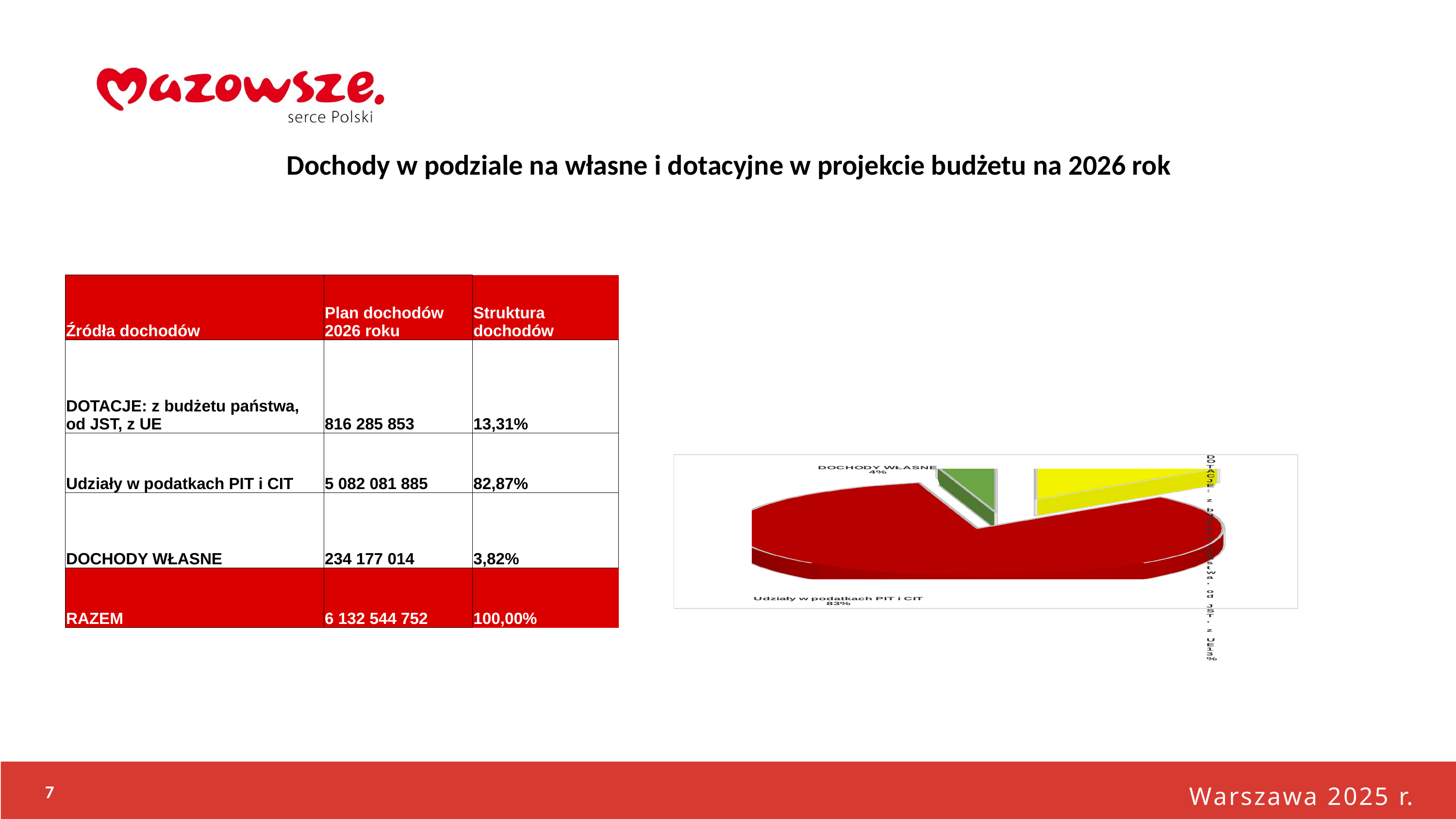
What share of the pie does "DOCHODY WŁASNE" have? 4% What share of the pie does "DOTACJE: z budżetu państwa, od JST, z UE" have? 13% What colour is the slice for Udziały w podatkach PIT i CIT in the pie chart? red How many slices does the pie chart have? 3 What colour is the slice for DOCHODY WŁASNE in the pie chart? green What is the difference in percentage points between the share for Udziały w podatkach PIT i CIT and the share for DOTACJE in the pie chart? 70 Which slice of the pie chart is the smallest? DOCHODY WŁASNE Which slice of the pie chart is the largest? Udziały w podatkach PIT i CIT Which is larger in the pie chart: the share for DOTACJE or the share for DOCHODY WŁASNE? DOTACJE What kind of chart is shown on the slide? pie chart What share of the pie does "Udziały w podatkach PIT i CIT" have? 83%